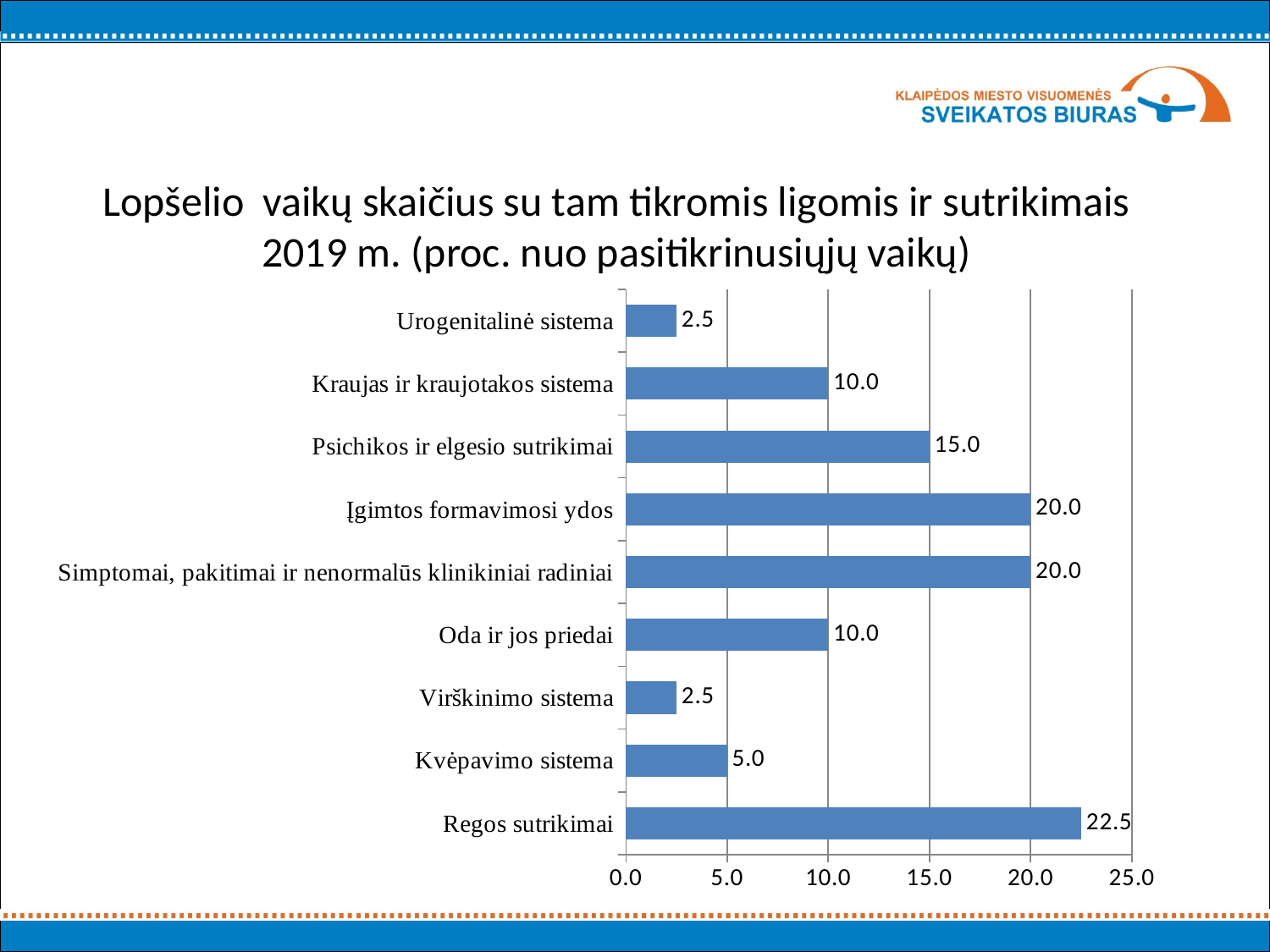
What is the value for Kvėpavimo sistema? 5.0 What is the difference between the values for Regos sutrikimai and Įgimtos formavimosi ydos? 2.5 What is the difference between the values for Psichikos ir elgesio sutrikimai and Kraujas ir kraujotakos sistema? 5.0 How many categories are shown in the chart? 9 Which two categories both have a value of 20.0? Įgimtos formavimosi ydos and Simptomai, pakitimai ir nenormalūs klinikiniai radiniai What kind of chart is shown on the slide? bar chart Which category has the highest value? Regos sutrikimai Is the value for Įgimtos formavimosi ydos greater or less than 15.0? greater What is the value for Psichikos ir elgesio sutrikimai? 15.0 Which is larger, the value for Oda ir jos priedai or the value for Kvėpavimo sistema? Oda ir jos priedai What is the value for Regos sutrikimai? 22.5 What is the maximum value shown on the x axis? 25.0